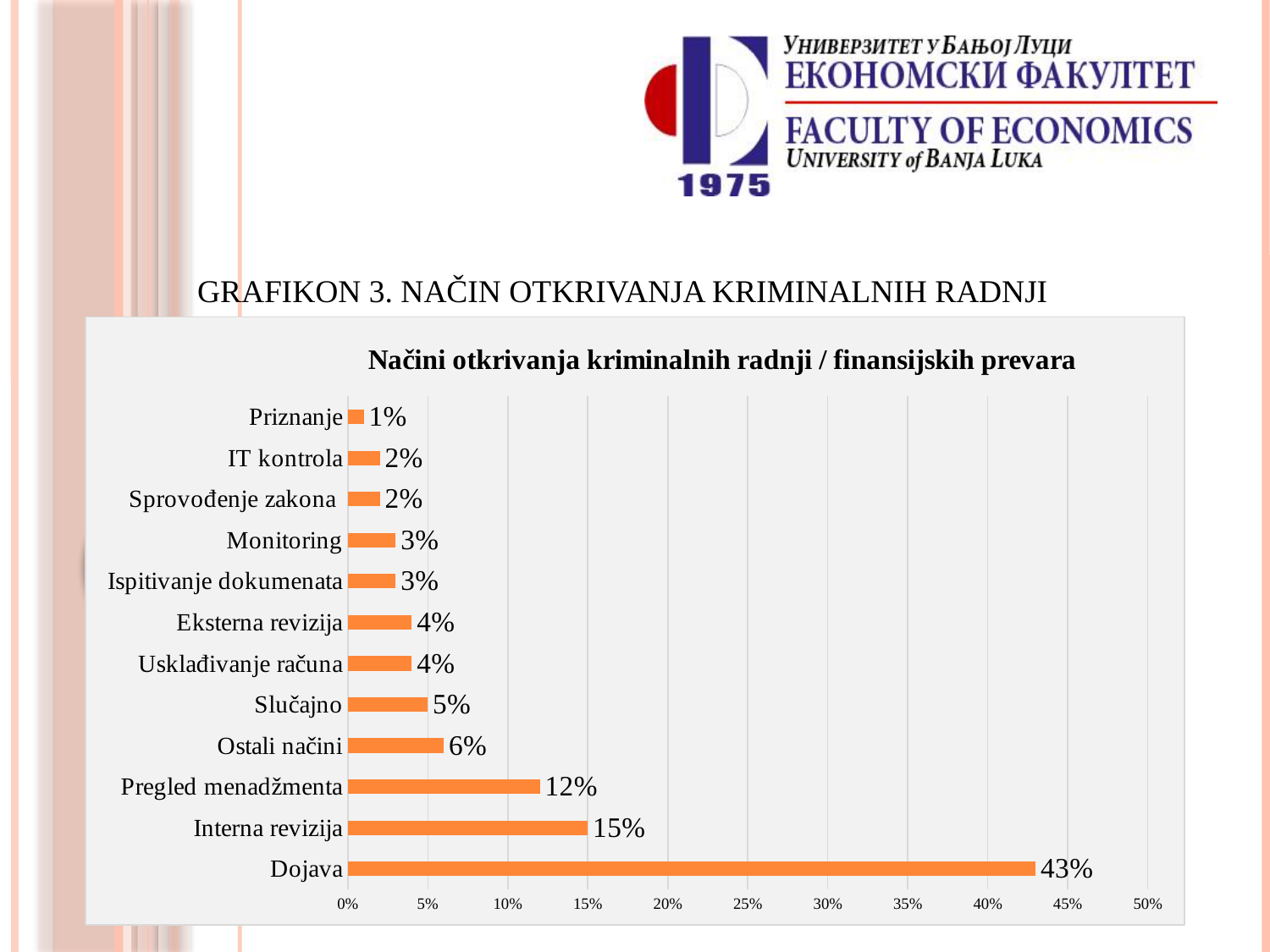
What is the value for Dojava? 43% What kind of chart is shown on the slide? bar chart How many categories are shown in the chart? 12 What is the value for Pregled menadžmenta? 12% Which is larger, the value for Ostali načini or the value for Slučajno? Ostali načini What is the title of the chart? Načini otkrivanja kriminalnih radnji / finansijskih prevara Which category has the lowest value? Priznanje Is the value for Dojava greater or less than 40%? greater What is the value for Slučajno? 5% What is the difference between the values for Dojava and Interna revizija? 28% Which category has the highest value? Dojava What is the value for Interna revizija? 15%